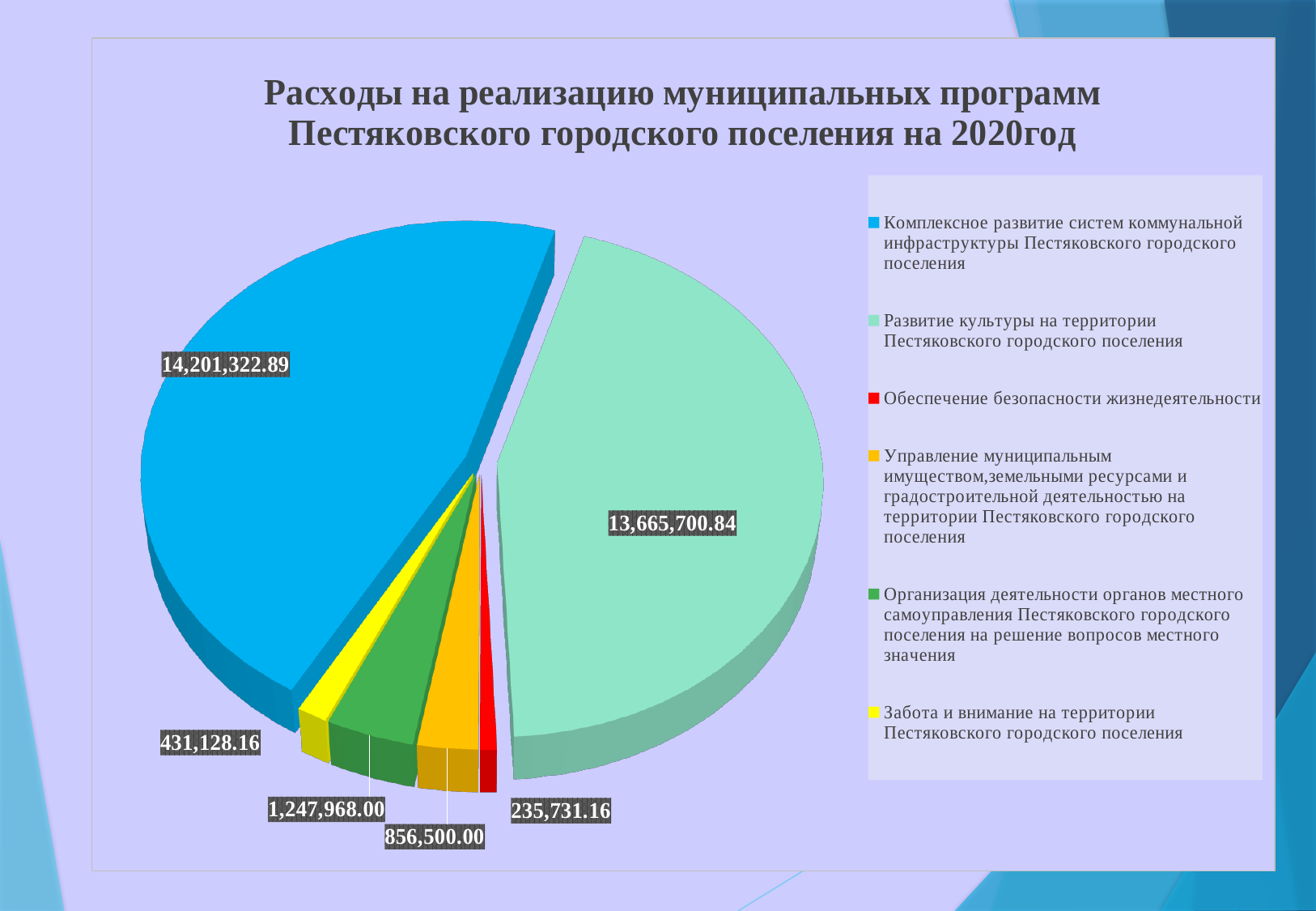
What colour is the slice for "Обеспечение безопасности жизнедеятельности"? Red What is the value for "Организация деятельности органов местного самоуправления Пестяковского городского поселения на решение вопросов местного значения"? 1,247,968.00 What type of chart is shown on the slide? Pie chart What is the value for "Комплексное развитие систем коммунальной инфраструктуры Пестяковского городского поселения"? 14,201,322.89 What is the value for "Обеспечение безопасности жизнедеятельности"? 235,731.16 Which category has the smallest slice of the pie? Обеспечение безопасности жизнедеятельности What is the value for "Забота и внимание на территории Пестяковского городского поселения"? 431,128.16 Which is larger: the value for "Управление муниципальным имуществом, земельными ресурсами и градостроительной деятельностью" or the value for "Организация деятельности органов местного самоуправления"? Организация деятельности органов местного самоуправления Which category has the largest slice of the pie? Комплексное развитие систем коммунальной инфраструктуры Пестяковского городского поселения What is the difference between the values for "Комплексное развитие систем коммунальной инфраструктуры" and "Развитие культуры"? 535,622.05 How many categories does the legend list? 6 What is the value for "Развитие культуры на территории Пестяковского городского поселения"? 13,665,700.84